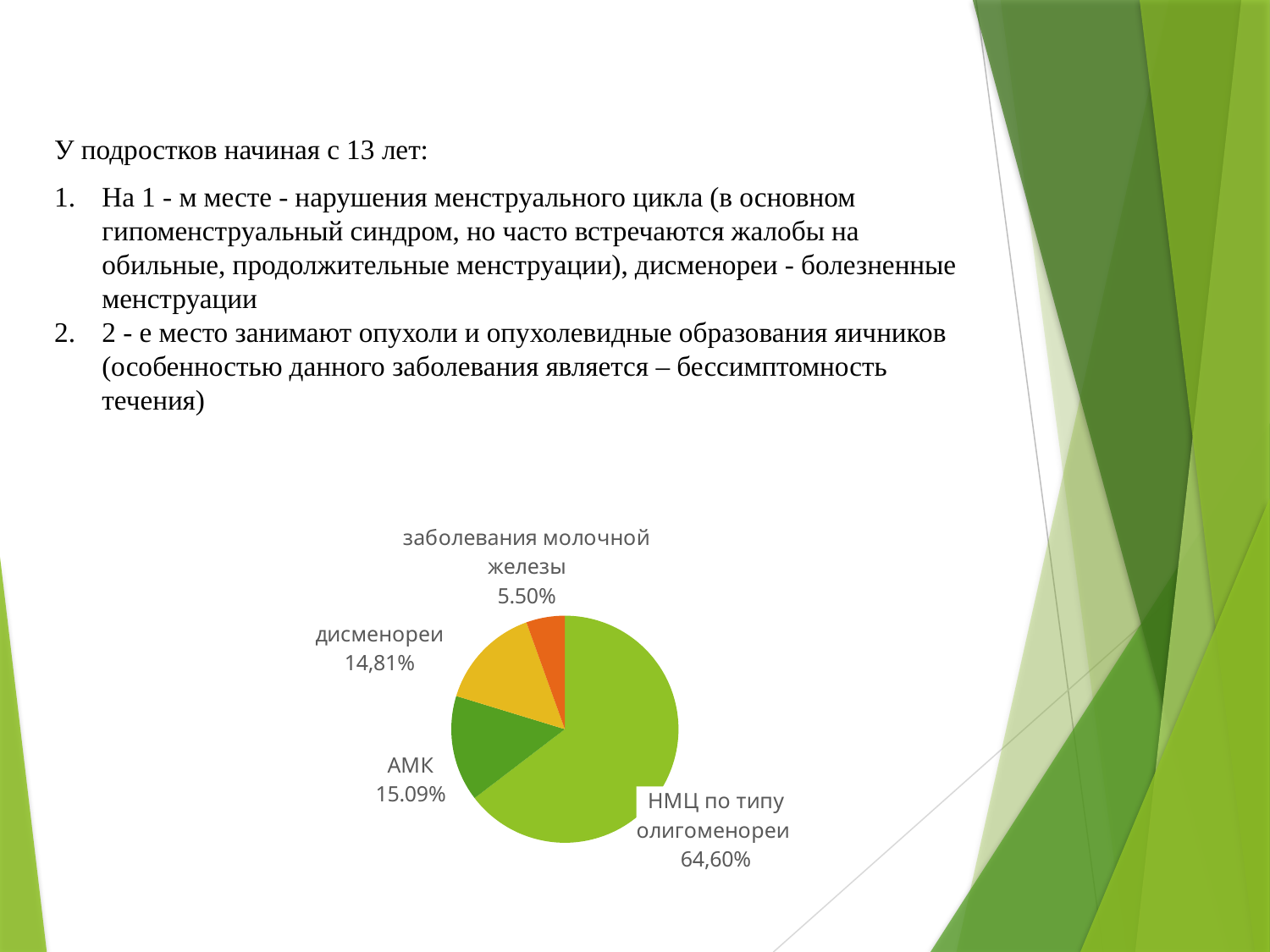
Which category has the smallest slice of the pie? заболевания молочной железы What colour is the slice for заболевания молочной железы? orange What share of the pie is labelled НМЦ по типу олигоменореи? 64,60% What is the value shown for дисменореи in the pie chart? 14,81% Which is larger in the pie chart: НМЦ по типу олигоменореи or АМК? НМЦ по типу олигоменореи Which category has the largest slice of the pie? НМЦ по типу олигоменореи What is the value shown for АМК in the pie chart? 15.09% What is the difference between the values for АМК and заболевания молочной железы? 9.59% What is the value shown for заболевания молочной железы in the pie chart? 5.50% What is the difference between the values for НМЦ по типу олигоменореи and дисменореи? 49,79% How many slices does the pie chart have? 4 What kind of chart is shown on the slide? pie chart